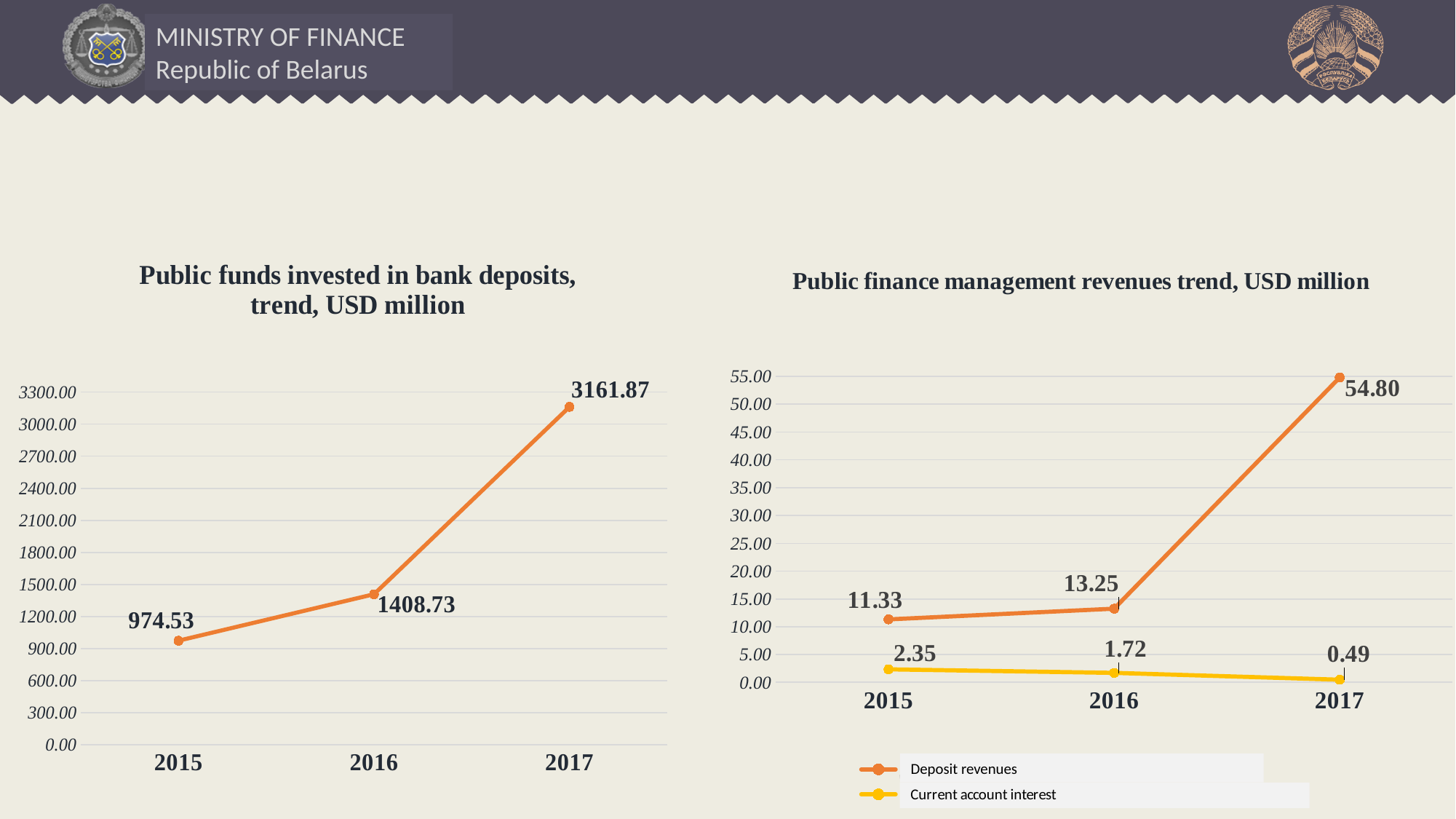
In the 'Public funds invested in bank deposits' chart, what is the difference between the 2017 and 2015 values? 2187.34 In the 'Public funds invested in bank deposits' chart, which year has the highest value? 2017 In the 'Public funds invested in bank deposits' chart, do the values rise or fall from 2015 to 2017? rise In the 'Public finance management revenues trend' chart, do the Current account interest values rise or fall from 2015 to 2017? fall In the 'Public finance management revenues trend' chart, which year has the lowest Current account interest value? 2017 In the 'Public finance management revenues trend' chart, what is the Deposit revenues value for 2017? 54.80 In the 'Public finance management revenues trend' chart, what is the Current account interest value for 2016? 1.72 In the 'Public funds invested in bank deposits' chart, what is the value for 2016? 1408.73 How many series does the legend of the 'Public finance management revenues trend' chart list? 2 In the 'Public finance management revenues trend' chart, which is larger in 2016: Deposit revenues or Current account interest? Deposit revenues In the 'Public finance management revenues trend' chart, what is the difference between Deposit revenues and Current account interest in 2015? 8.98 What kind of chart is the 'Public funds invested in bank deposits' chart? line chart